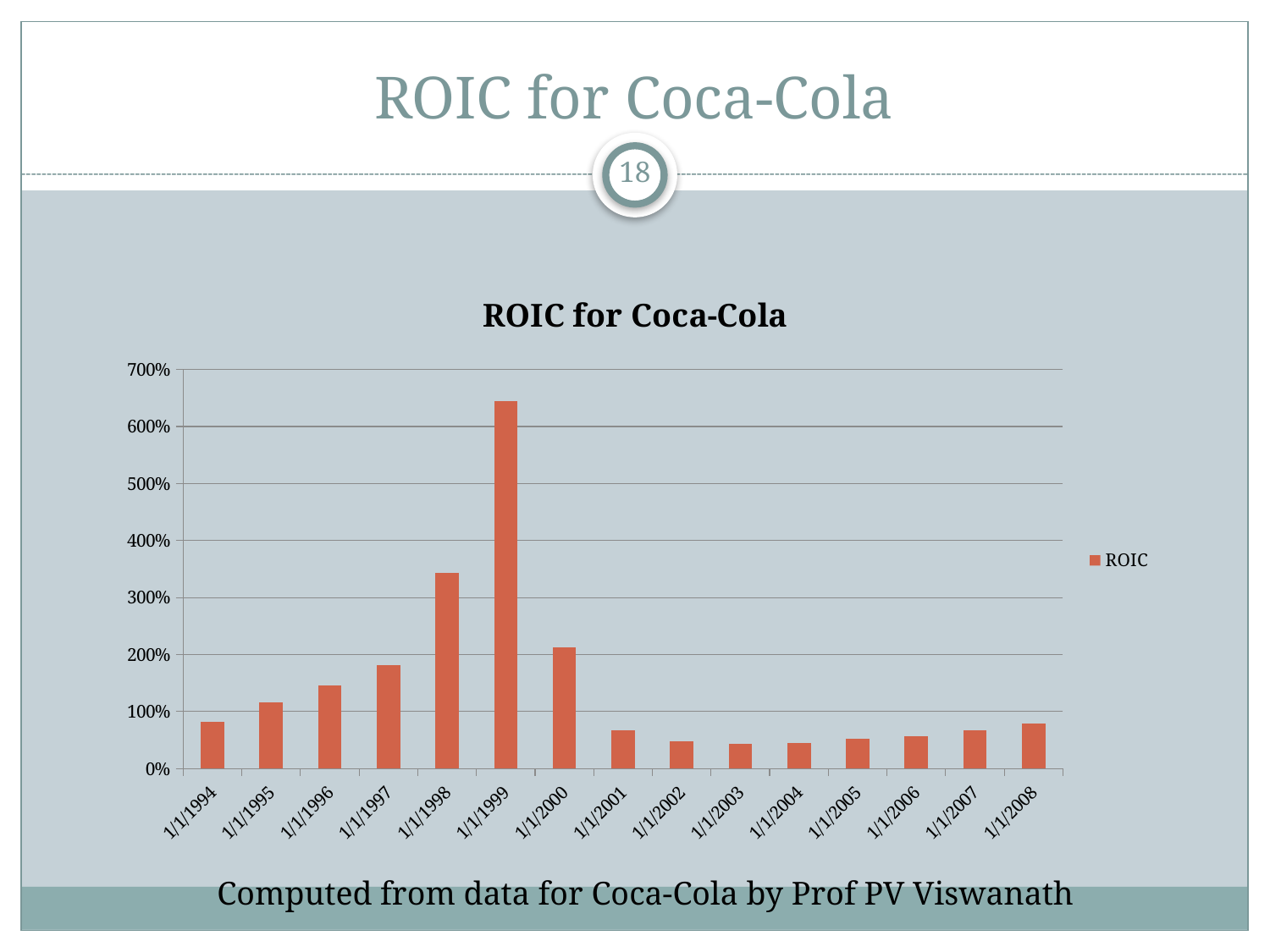
How many series does the legend list? 1 Which date has the highest ROIC? 1/1/1999 How many dates are shown on the x axis? 15 Is the ROIC for 1/1/1999 greater or less than 600%? greater Is the ROIC for 1/1/1998 greater or less than 300%? greater Is the ROIC for 1/1/2001 greater or less than 100%? less What kind of chart is shown on the slide? bar chart What is the title of the chart? ROIC for Coca-Cola Which has a higher ROIC, 1/1/1998 or 1/1/2000? 1/1/1998 What is the name of the series shown in the legend? ROIC Do the ROIC values rise or fall from 1/1/1994 to 1/1/1999? rise